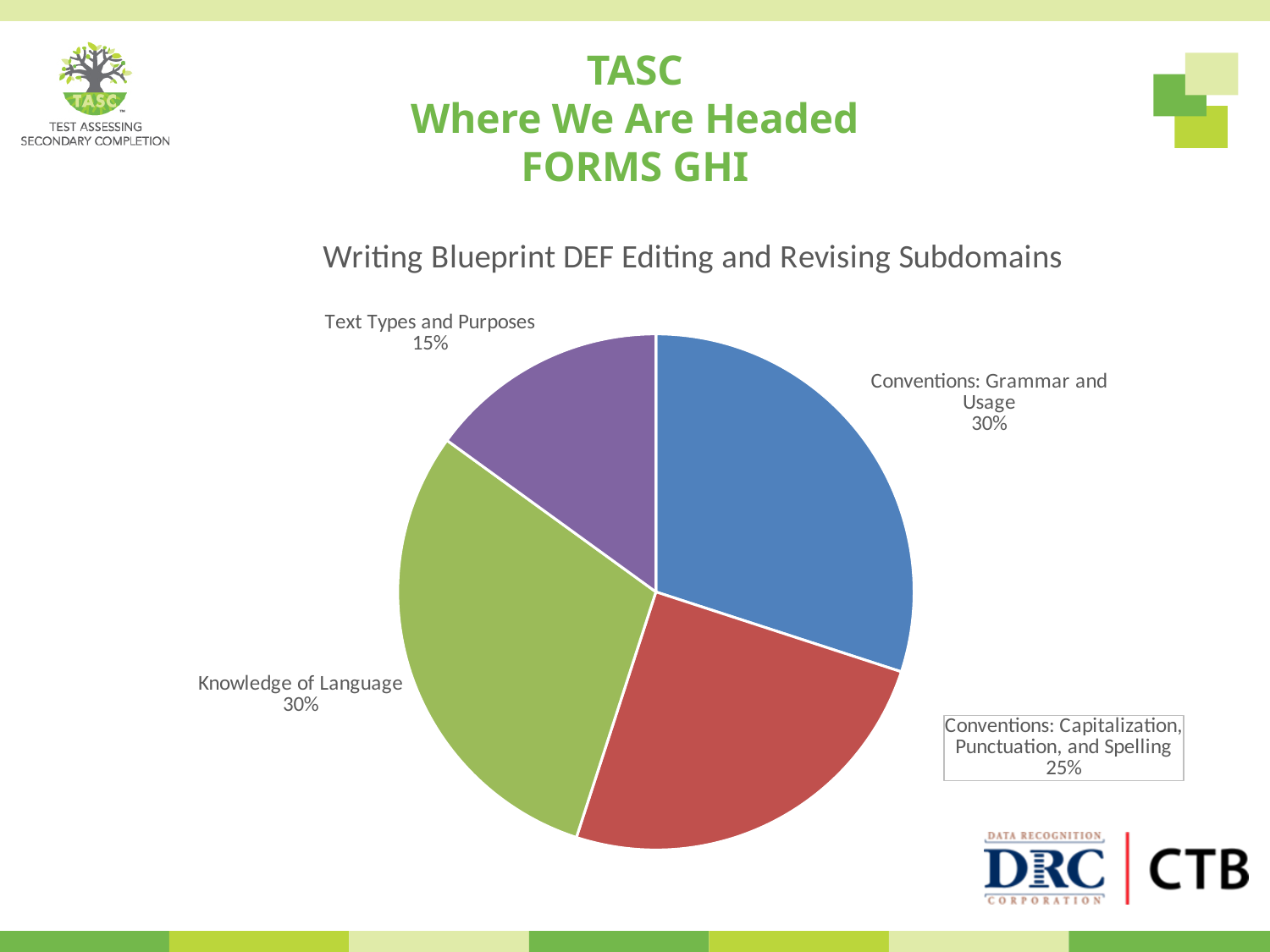
What is the difference between the shares for Knowledge of Language and Text Types and Purposes? 15% What is the combined share of the two Conventions slices? 55% Which subdomain has the smallest share of the pie? Text Types and Purposes What colour is the Knowledge of Language slice? Green What share of the pie is Knowledge of Language? 30% What share of the pie is Conventions: Grammar and Usage? 30% How many slices does the pie chart have? 4 Which is larger, the share for Conventions: Capitalization, Punctuation, and Spelling or the share for Text Types and Purposes? Conventions: Capitalization, Punctuation, and Spelling What share of the pie is Conventions: Capitalization, Punctuation, and Spelling? 25% What is the title of the chart? Writing Blueprint DEF Editing and Revising Subdomains What kind of chart is shown on the slide? Pie chart What share of the pie is Text Types and Purposes? 15%